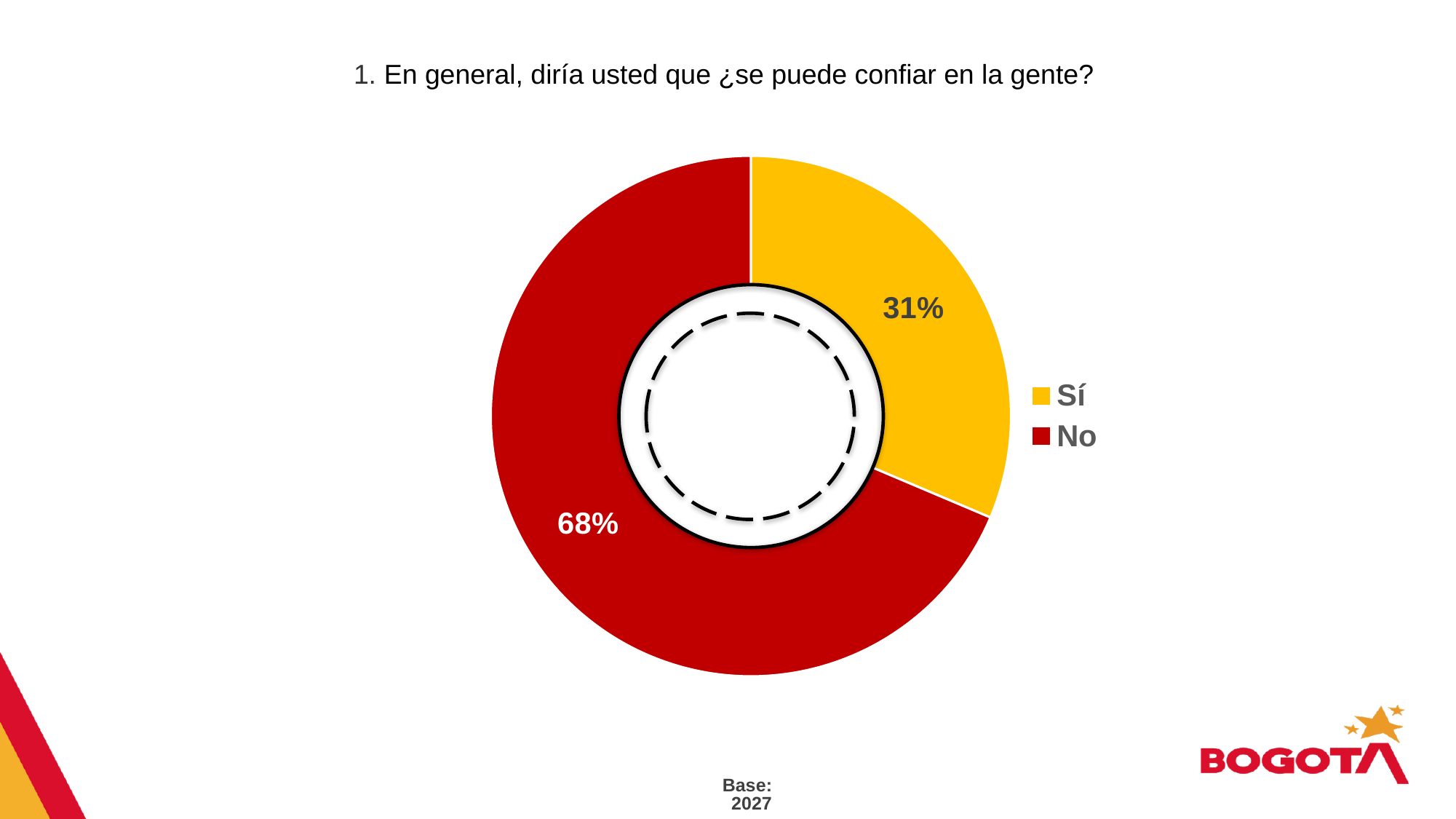
How many categories does the chart show? 2 Which response has the smallest share of the pie? Sí What percentage of respondents answered "No"? 68% What is the difference in percentage points between the "No" and "Sí" responses? 37 Which is larger, the share for "Sí" or the share for "No"? No Which response has the largest share of the pie? No What kind of chart is shown on the slide? Doughnut chart What is the base (number of respondents) shown below the chart? 2027 How many entries does the legend list? 2 What percentage of respondents answered "Sí"? 31% What colour represents the "No" response in the chart? Red